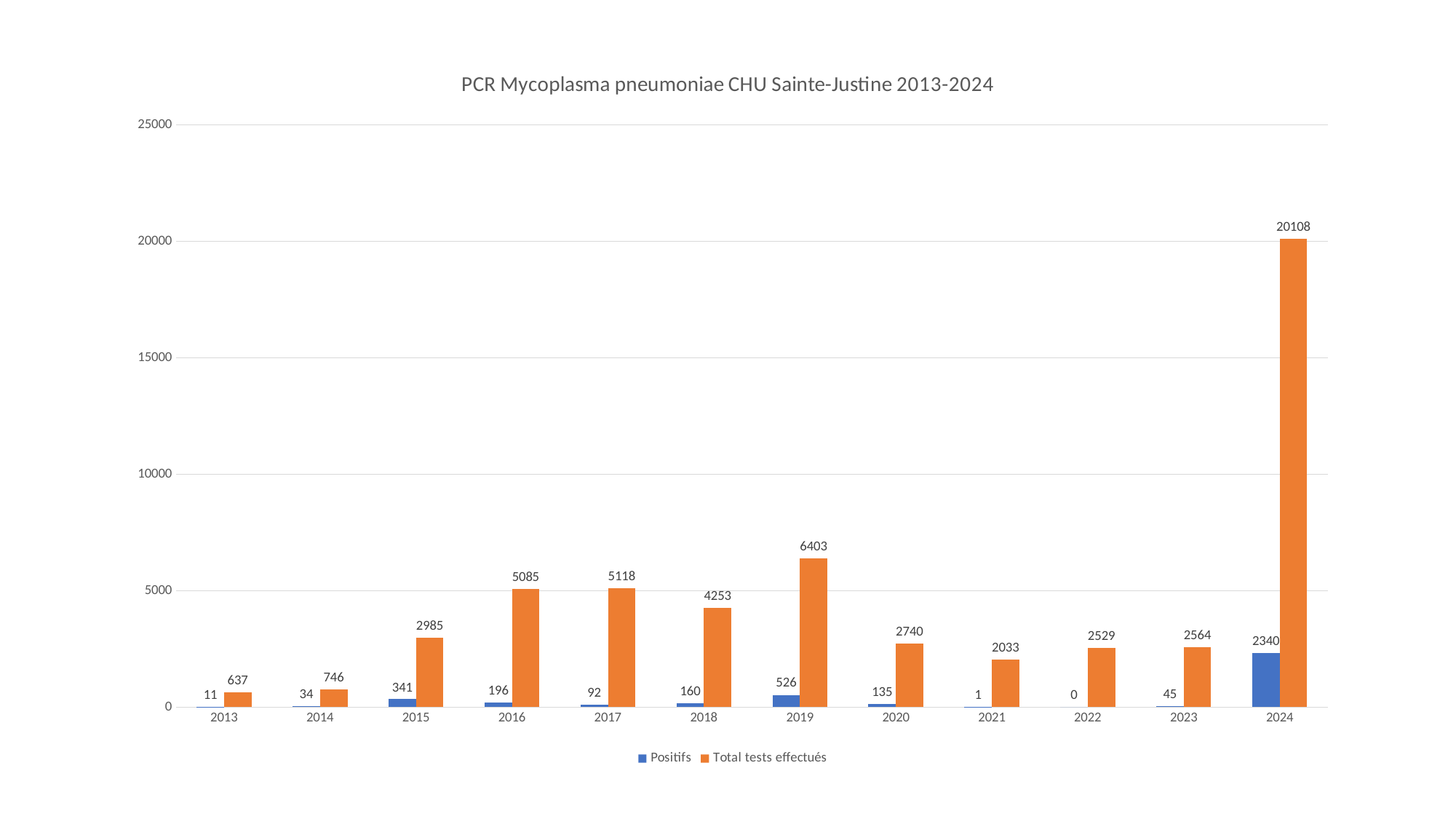
What is the value of Total tests effectués for 2024? 20108 Is the value of Total tests effectués for 2017 greater or less than 5000? greater What is the difference between Total tests effectués in 2019 and in 2018? 2150 Which year has the highest value for Total tests effectués? 2024 How many years are shown on the x axis? 12 What is the value of Total tests effectués for 2016? 5085 Which is larger: Positifs in 2015 or Positifs in 2016? 2015 What kind of chart is shown on the slide? bar chart How many series does the legend list? 2 What is the value of Positifs for 2019? 526 Which year has the lowest value for Positifs? 2022 What is the title of the chart? PCR Mycoplasma pneumoniae CHU Sainte-Justine 2013-2024